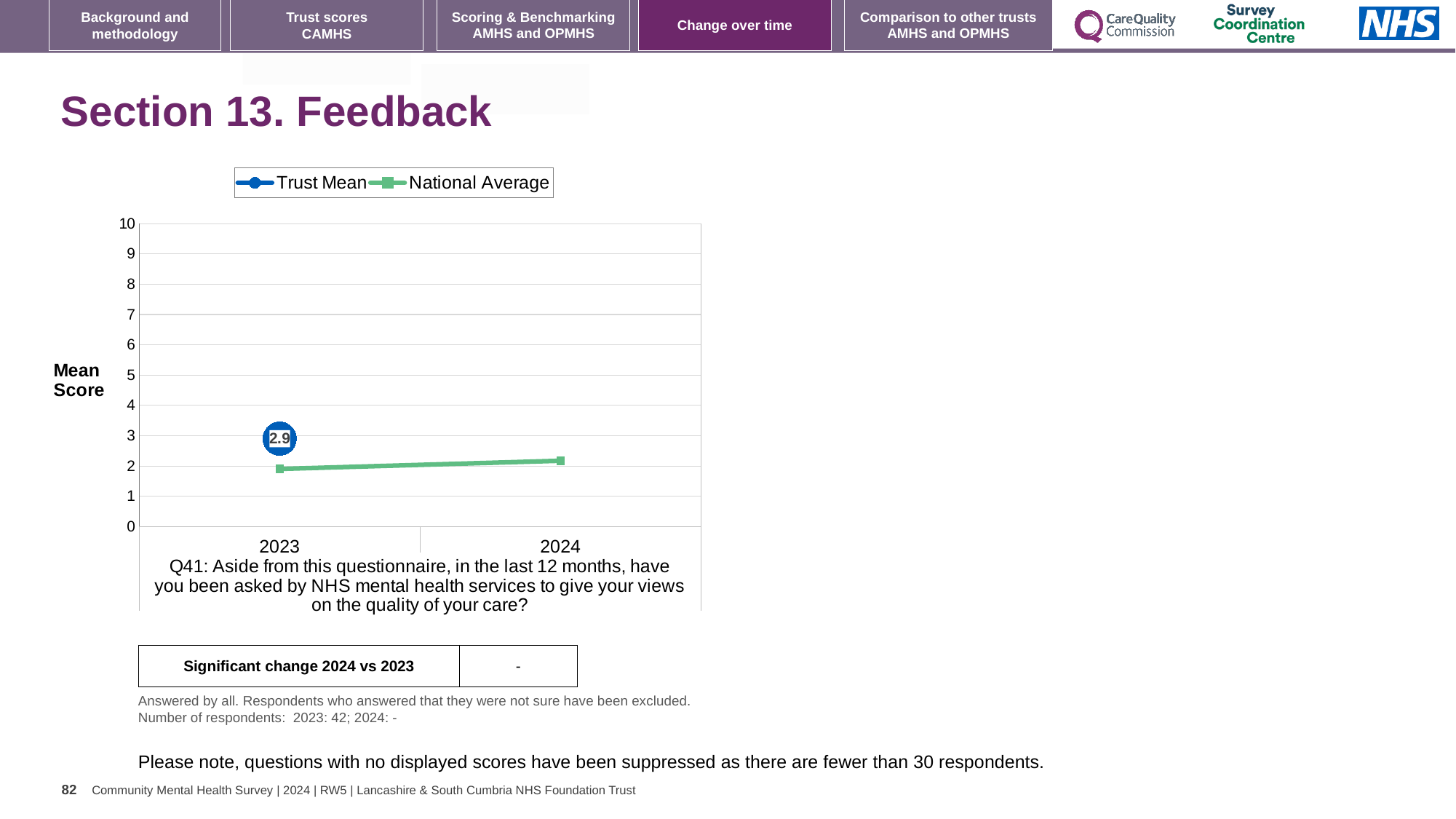
What are the two series named in the legend? Trust Mean and National Average What is the label on the y axis of the chart? Mean Score What kind of chart is shown on the slide? Line chart Does the National Average rise or fall from 2023 to 2024? Rise What is the Trust Mean score for 2023? 2.9 Is the National Average value for 2024 greater or less than 3? less Is the National Average value for 2023 greater or less than 1? greater Is the National Average value for 2023 greater or less than 3? less In 2023, which is higher: the Trust Mean or the National Average? Trust Mean How many years are shown on the x axis? 2 How many series does the legend list? 2